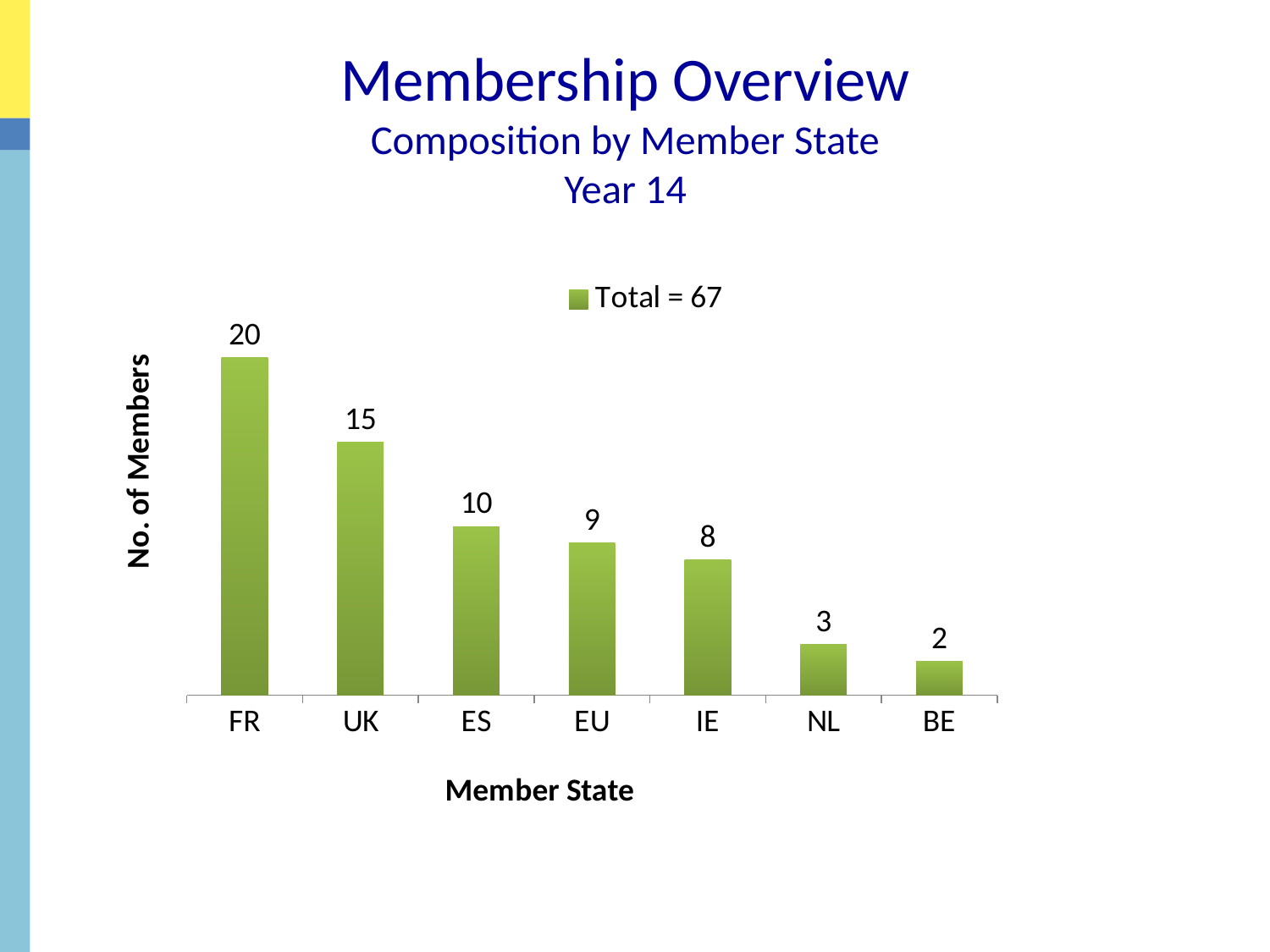
Which has more members, ES or EU? ES Do the values rise or fall from left to right along the x axis? Fall What is the number of members for FR? 20 What does the legend entry say? Total = 67 Which member state has the highest number of members? FR What is the number of members for BE? 2 What is the difference in number of members between FR and UK? 5 What kind of chart is shown on the slide? Bar chart What is the number of members for IE? 8 What is the number of members for UK? 15 How many member states are shown on the x axis? 7 Which member state has the lowest number of members? BE